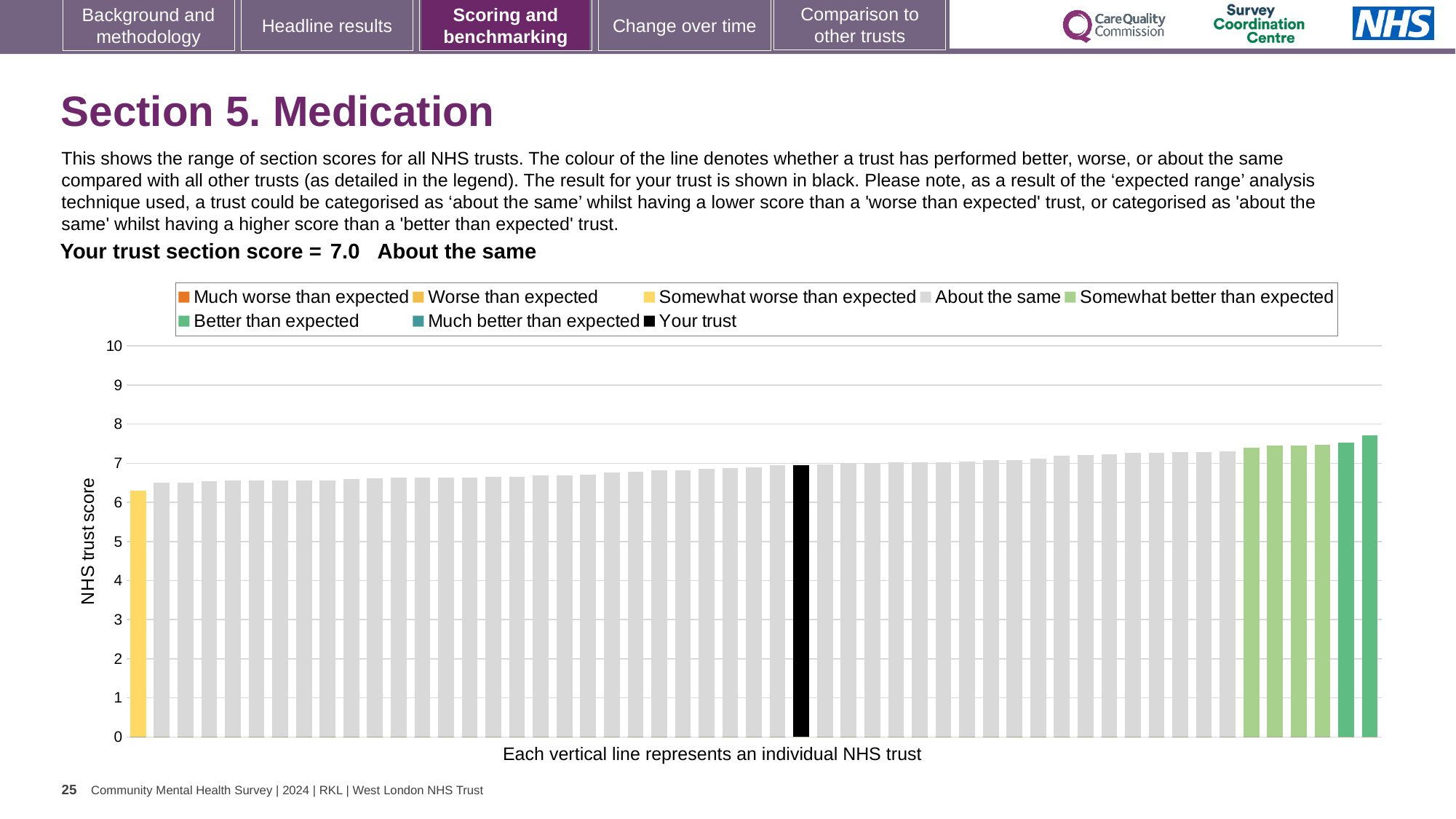
What kind of chart is shown on the slide? bar chart Do the bar values rise or fall from left to right along the x axis? rise Is the value of the leftmost (yellow) bar greater or less than 6? greater Is the value of the rightmost bar greater or less than 8? less Is the value of the leftmost (yellow) bar greater or less than 7? less Which benchmarking category is your trust's section score placed in? About the same How many entries does the chart legend list? 8 What is the label on the y axis of the chart? NHS trust score What colour is the bar representing your trust? black What is the section score for your trust shown on the slide? 7.0 How many bars are coloured yellow (worse than expected)? 1